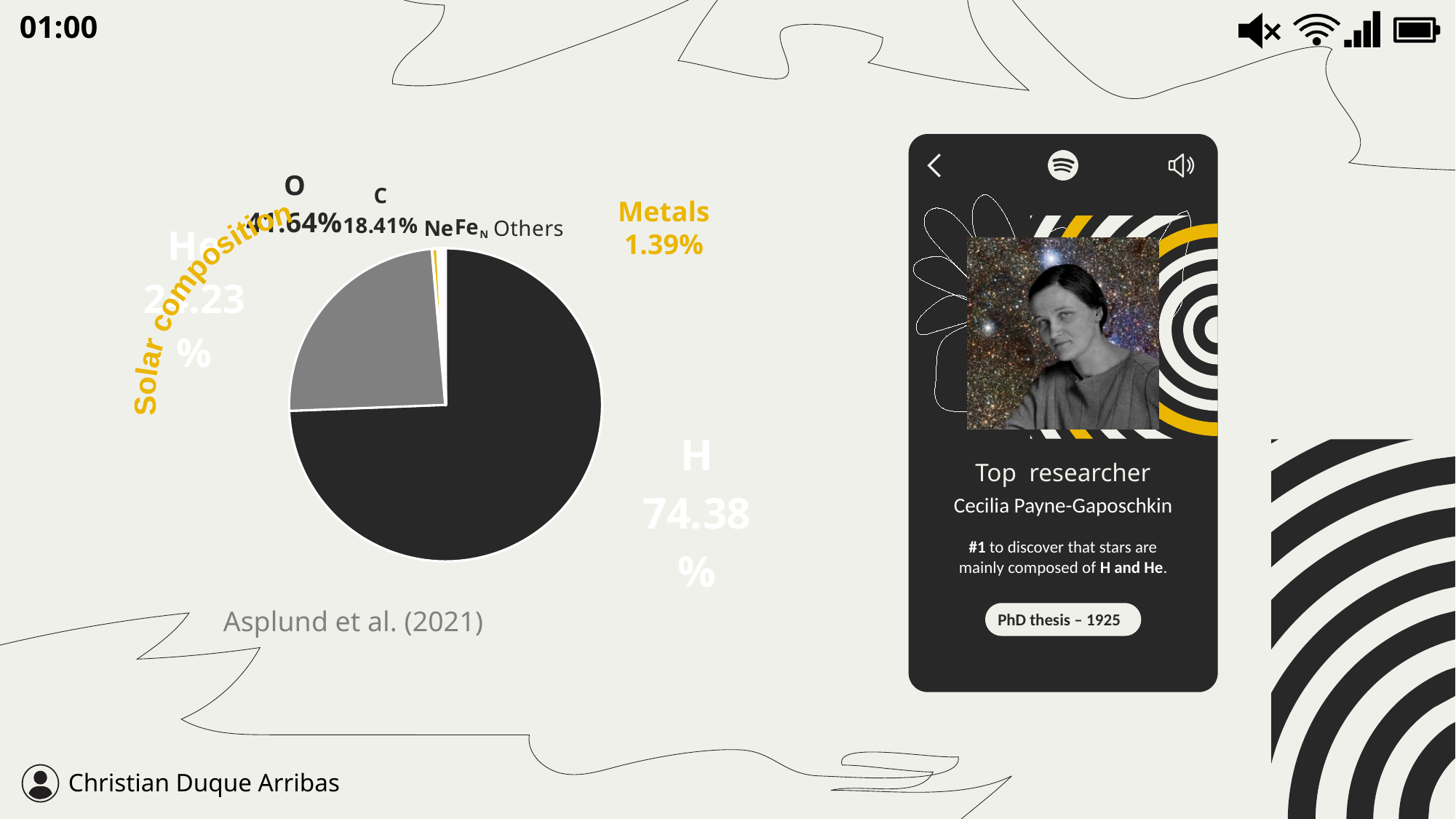
What percentage of the solar composition is H according to the chart? 74.38% What percentage of the solar composition is Metals according to the chart? 1.39% What kind of chart is shown on the slide? pie chart What is the difference between the H share and the Metals share? 72.99% What percentage is shown for C in the metals breakdown? 18.41% What share of the pie does H represent? 74.38% Which is larger in the pie chart, H or He? H Which is larger in the pie chart, He or Metals? He Which element makes up the largest slice of the pie chart? H What is the title of the chart? Solar composition Which source is cited below the chart? Asplund et al. (2021)